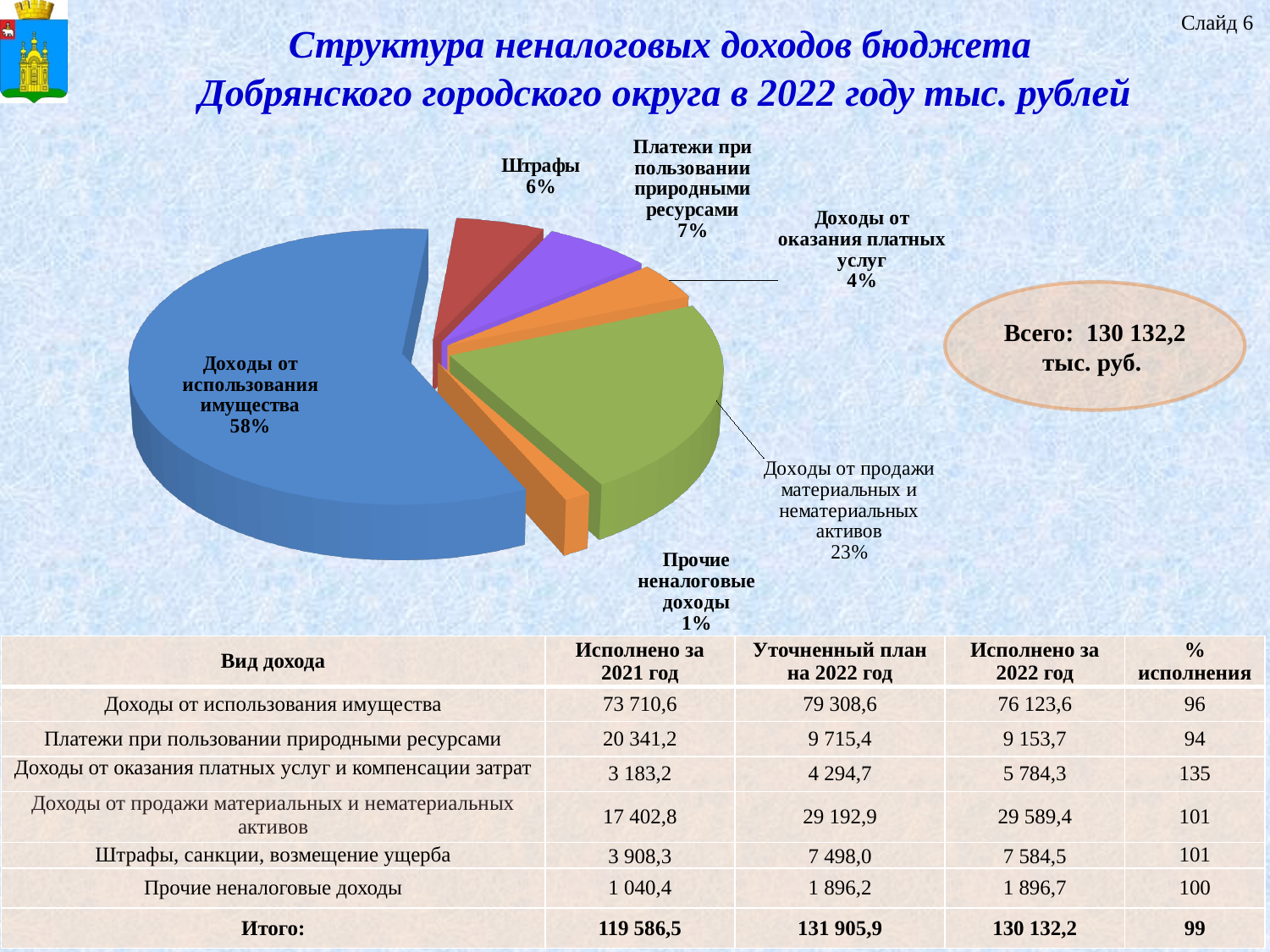
What percentage is shown for "Платежи при пользовании природными ресурсами" in the pie chart? 7% What share of the pie does "Доходы от продажи материальных и нематериальных активов" have? 23% What percentage is shown for "Штрафы" in the pie chart? 6% Which is larger in the pie chart: "Штрафы" or "Платежи при пользовании природными ресурсами"? Платежи при пользовании природными ресурсами How many slices does the pie chart have? 6 What percentage is shown for "Доходы от оказания платных услуг" in the pie chart? 4% What is the difference in percentage points between "Доходы от использования имущества" and "Доходы от продажи материальных и нематериальных активов"? 35 What percentage is shown for "Прочие неналоговые доходы" in the pie chart? 1% What type of chart is shown on the slide? pie chart Which category has the smallest slice of the pie chart? Прочие неналоговые доходы Which category has the largest slice of the pie chart? Доходы от использования имущества What share of the pie does "Доходы от использования имущества" have? 58%